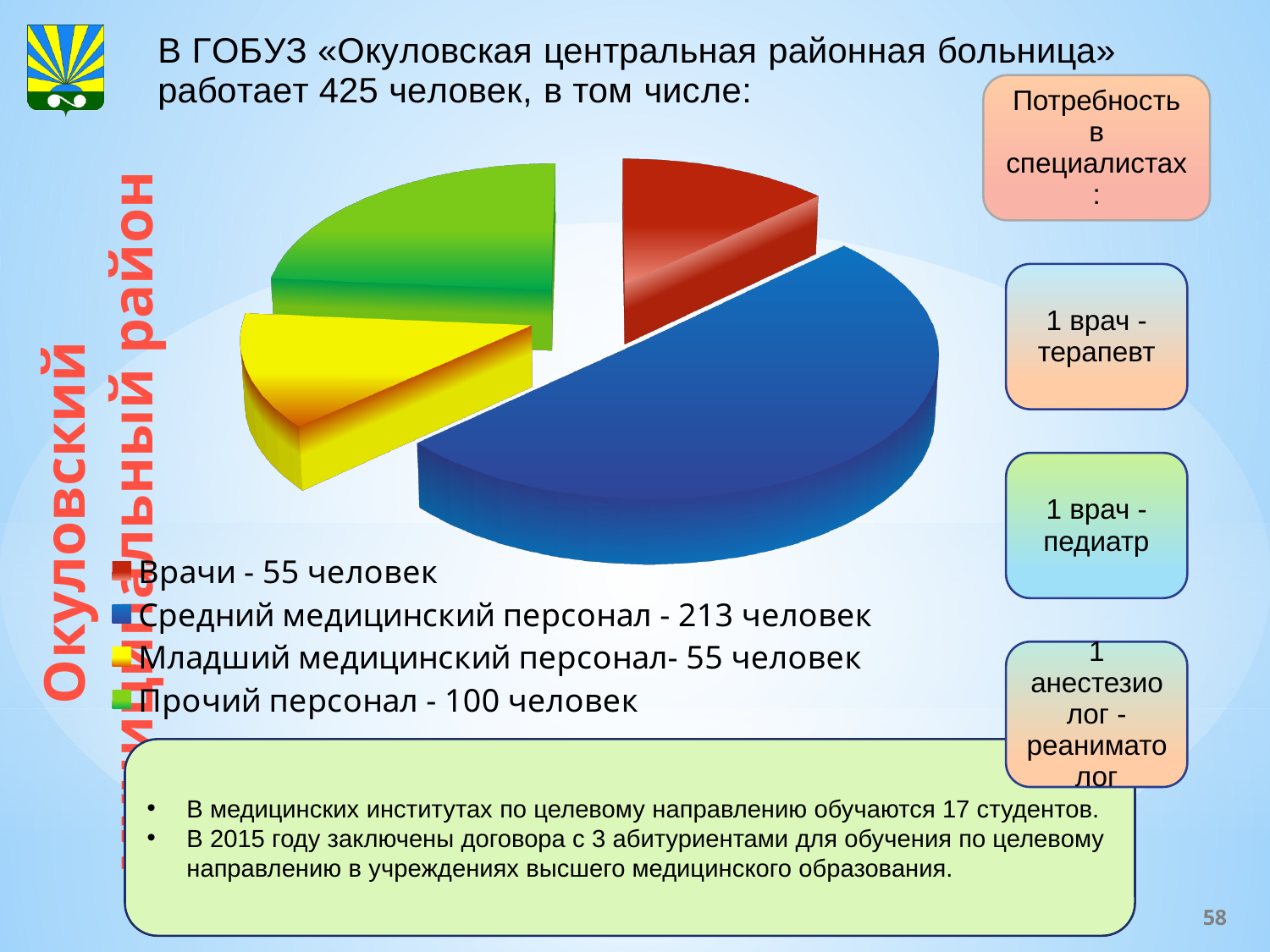
What type of chart is shown on the slide? pie chart Which colour represents "Средний медицинский персонал" in the pie chart? blue How many people are in the category "Прочий персонал"? 100 человек How many people are in the category "Врачи"? 55 человек What is the difference between "Прочий персонал" and "Младший медицинский персонал"? 45 человек Which category is shown in green in the pie chart? Прочий персонал How many people are in the category "Младший медицинский персонал"? 55 человек Which is larger: "Прочий персонал" or "Врачи"? Прочий персонал What is the difference between "Средний медицинский персонал" and "Прочий персонал"? 113 человек How many people are in the category "Средний медицинский персонал"? 213 человек How many categories does the pie chart have? 4 Which category has the largest slice of the pie chart? Средний медицинский персонал